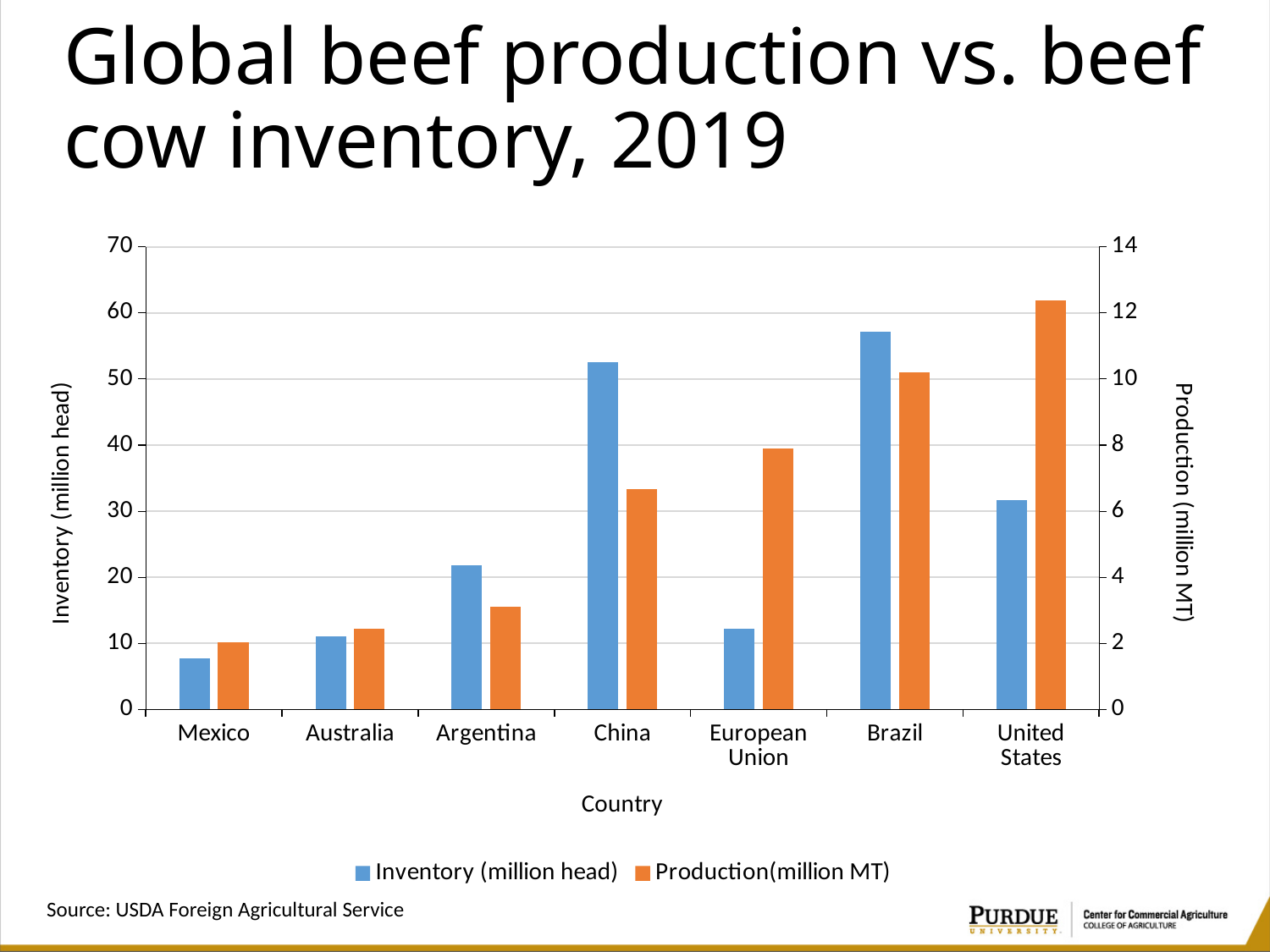
Which country has the highest production (million MT)? United States Which has the larger inventory (million head), China or the United States? China What is the label of the right-hand vertical axis? Production (million MT) How many series does the legend list? 2 Which country has the lowest inventory (million head)? Mexico Which has the larger production (million MT), Brazil or China? Brazil Which country has the lowest production (million MT)? Mexico Which country has the highest inventory (million head)? Brazil How many countries are shown on the x axis? 7 Is the inventory (million head) for China greater or less than 50? greater What kind of chart is shown on the slide? bar chart